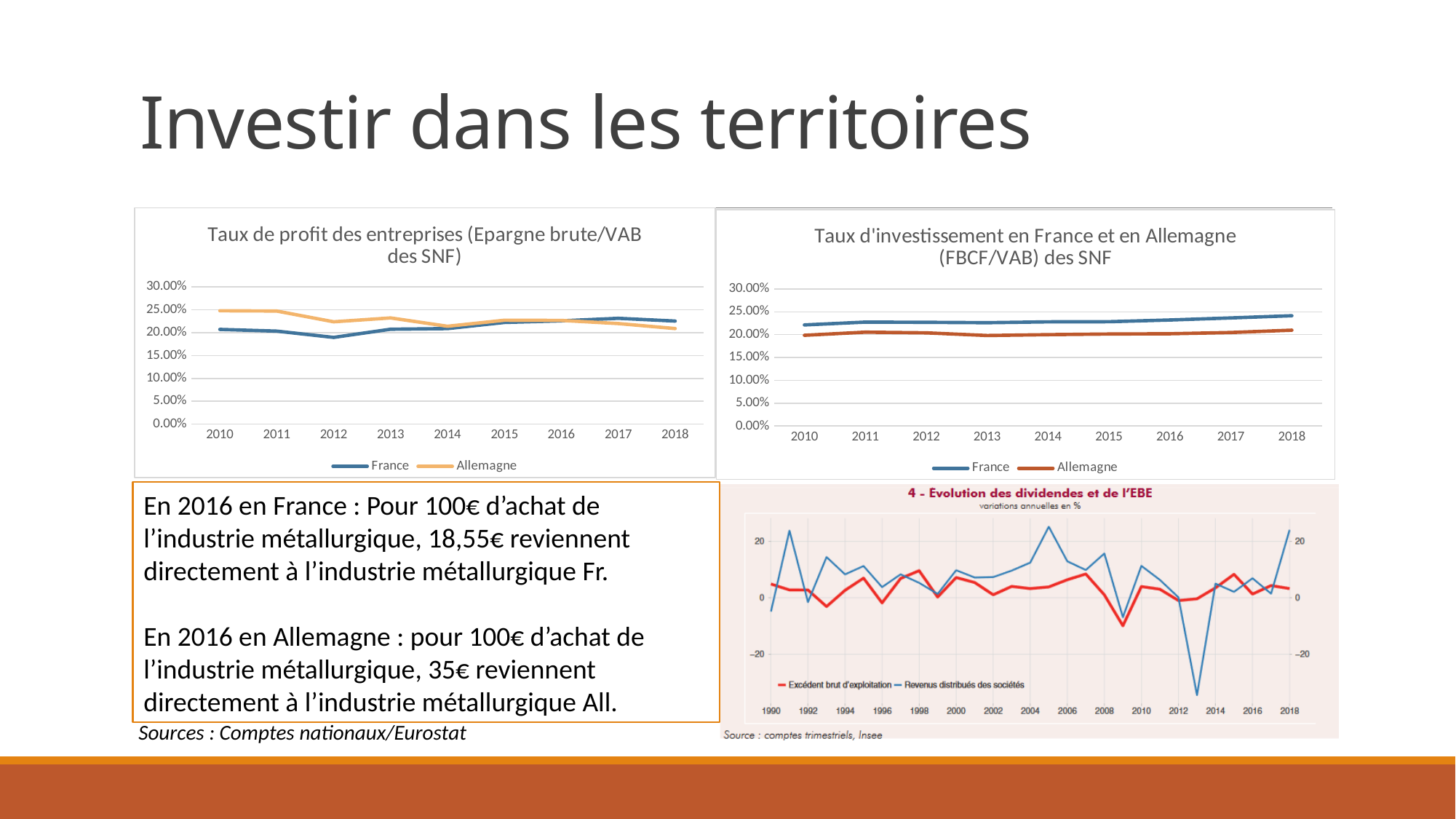
How many years are shown on the x axis of 'Taux de profit des entreprises (Epargne brute/VAB des SNF)'? 9 In 'Taux de profit des entreprises (Epargne brute/VAB des SNF)', in which year is the France series at its lowest? 2012 In 'Taux d'investissement en France et en Allemagne (FBCF/VAB) des SNF', is the value for France in 2018 greater or less than 20.00%? greater In 'Taux de profit des entreprises (Epargne brute/VAB des SNF)', is the value for France in 2012 greater or less than 20.00%? less In 'Taux d'investissement en France et en Allemagne (FBCF/VAB) des SNF', which series is higher in 2018, France or Allemagne? France What type of chart is 'Taux de profit des entreprises (Epargne brute/VAB des SNF)'? Line chart In the chart 'Evolution des dividendes et de l'EBE', which two series does the legend list? Excédent brut d'exploitation and Revenus distribués des sociétés How many series does the legend of 'Taux de profit des entreprises (Epargne brute/VAB des SNF)' list? 2 In the chart 'Evolution des dividendes et de l'EBE', is the value for Revenus distribués des sociétés in 2013 greater or less than -20? less In 'Taux de profit des entreprises (Epargne brute/VAB des SNF)', which series is higher in 2010, France or Allemagne? Allemagne In 'Taux de profit des entreprises (Epargne brute/VAB des SNF)', which series is higher in 2018, France or Allemagne? France In 'Taux d'investissement en France et en Allemagne (FBCF/VAB) des SNF', does the France series generally rise or fall from 2010 to 2018? Rise